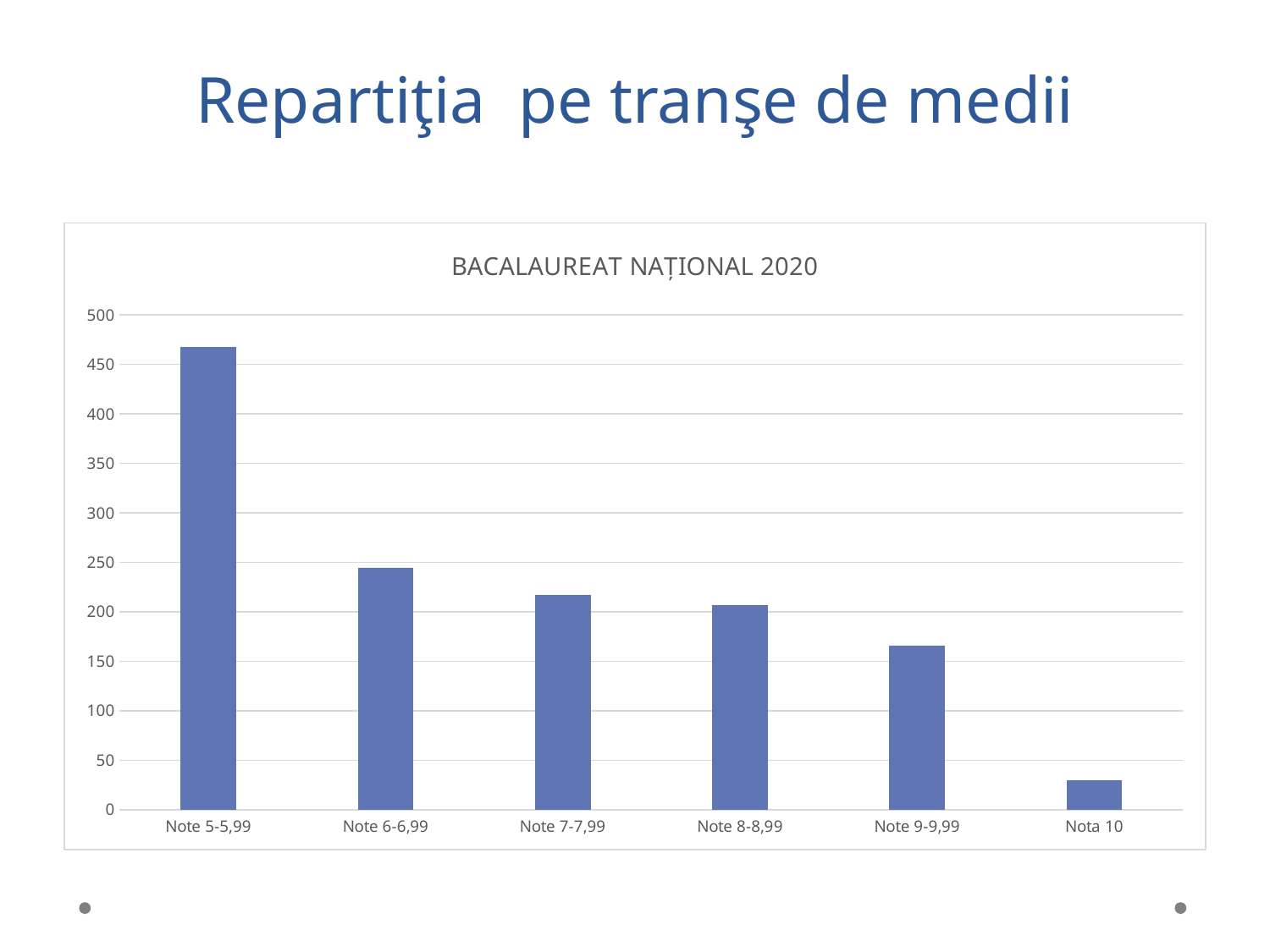
What type of chart is shown on the slide? bar chart Is the value for Nota 10 greater or less than 50? less Is the value for Note 5-5,99 greater or less than 450? greater How many categories are shown on the x axis of the chart? 6 Is the value for Note 6-6,99 greater or less than 250? less Which is larger, the value for Note 6-6,99 or the value for Note 8-8,99? Note 6-6,99 Do the values rise or fall from left to right along the x axis? fall What is the title of the chart? BACALAUREAT NAȚIONAL 2020 Which category has the lowest value? Nota 10 Which category has the highest value? Note 5-5,99